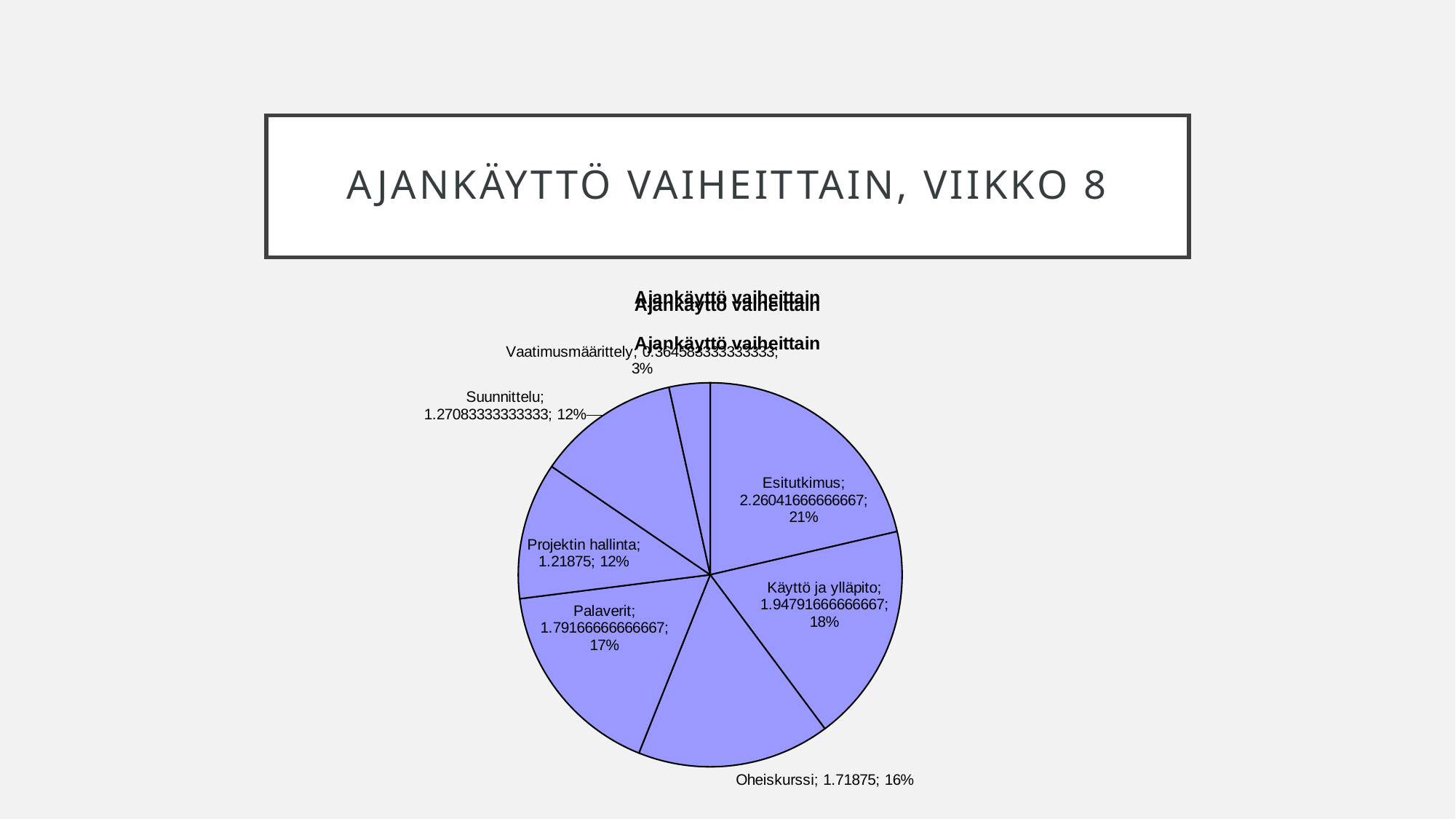
What value is shown for Oheiskurssi? 1.71875 What share of the pie does Palaverit represent? 17% What is the difference in percentage share between Esitutkimus and Käyttö ja ylläpito? 3% What share of the pie does Esitutkimus represent? 21% Which category has the smallest slice of the pie? Vaatimusmäärittely Which category has the largest slice of the pie? Esitutkimus What kind of chart is shown on the slide? pie chart What value is shown for Projektin hallinta? 1.21875 What is the title of the chart? Ajankäyttö vaiheittain How many slices does the pie chart have? 7 Which is larger, the value for Palaverit or the value for Oheiskurssi? Palaverit What value is shown for Käyttö ja ylläpito? 1.94791666666667